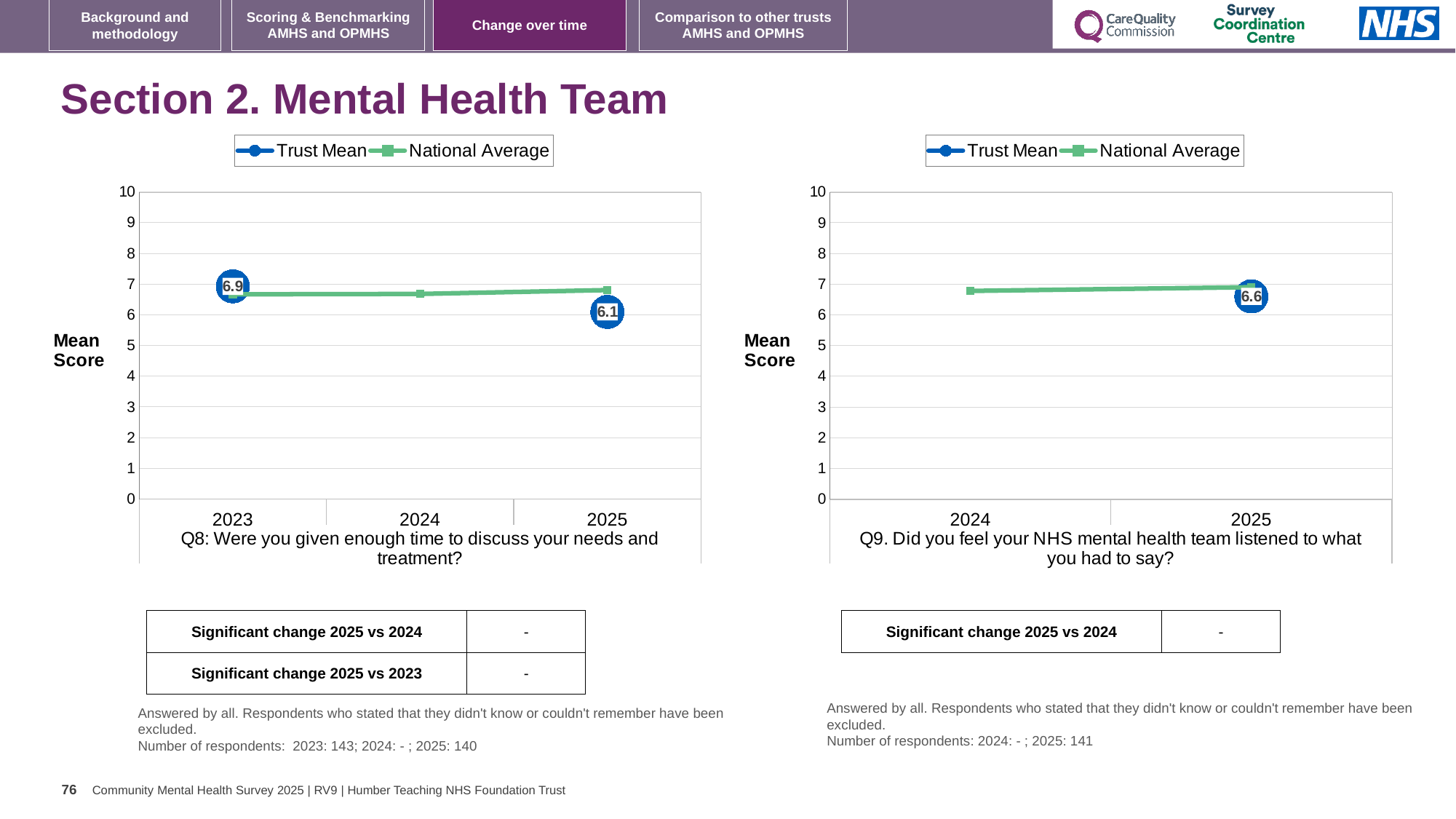
How many series does the legend of the left chart (Q8) list? 2 In the left chart (Q8), does the Trust Mean rise or fall from 2023 to 2025? fall In the right chart (Q9), is the National Average value for 2024 greater or less than 5? greater In the left chart (Q8), what is the Trust Mean for 2023? 6.9 In the left chart (Q8), which year has the higher Trust Mean, 2023 or 2025? 2023 In the right chart (Q9), what is the Trust Mean for 2025? 6.6 In the left chart (Q8), what is the difference between the Trust Mean for 2023 and the Trust Mean for 2025? 0.8 What are the two series named in the legend of the right chart (Q9)? Trust Mean and National Average In the left chart (Q8), what is the Trust Mean for 2025? 6.1 How many years are shown on the x axis of the right chart (Q9)? 2 How many years are shown on the x axis of the left chart (Q8)? 3 What kind of chart is the right chart (Q9)? line chart